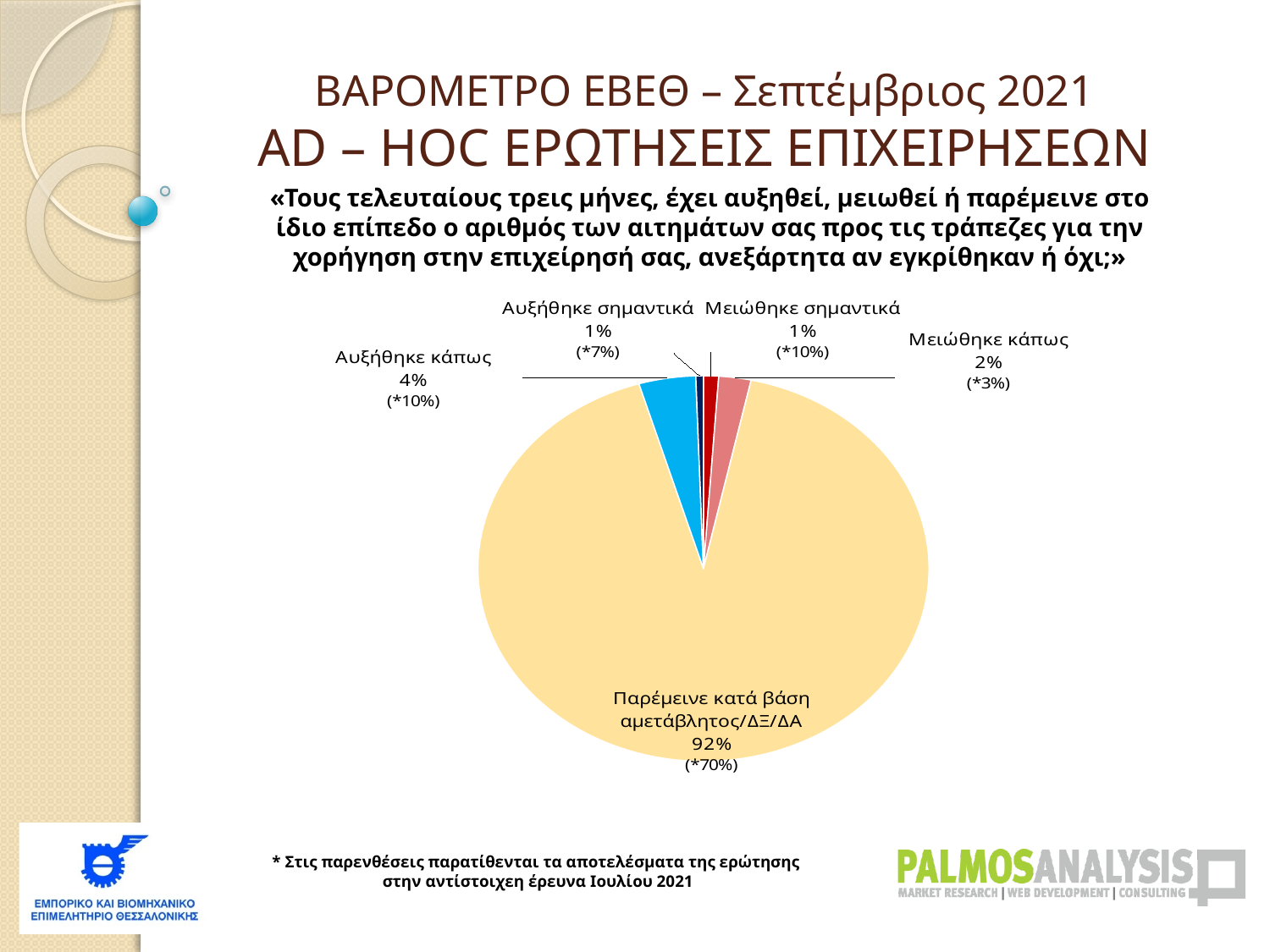
Which category has the largest slice of the pie? Παρέμεινε κατά βάση αμετάβλητος/ΔΞ/ΔΑ What was the July 2021 value shown in parentheses for "Μειώθηκε σημαντικά"? 10% What is the difference in percentage points between "Παρέμεινε κατά βάση αμετάβλητος/ΔΞ/ΔΑ" and "Αυξήθηκε κάπως"? 88 percentage points What kind of chart is shown on the slide? pie chart What percentage is shown for "Αυξήθηκε κάπως"? 4% What percentage is shown for "Αυξήθηκε σημαντικά"? 1% What percentage is shown for "Παρέμεινε κατά βάση αμετάβλητος/ΔΞ/ΔΑ"? 92% What colour is the largest slice of the pie chart? light yellow Which is larger, the slice for "Αυξήθηκε κάπως" or the slice for "Μειώθηκε κάπως"? Αυξήθηκε κάπως How many slices does the pie chart have? 5 What was the July 2021 value shown in parentheses for "Παρέμεινε κατά βάση αμετάβλητος/ΔΞ/ΔΑ"? 70% What percentage is shown for "Μειώθηκε κάπως"? 2%